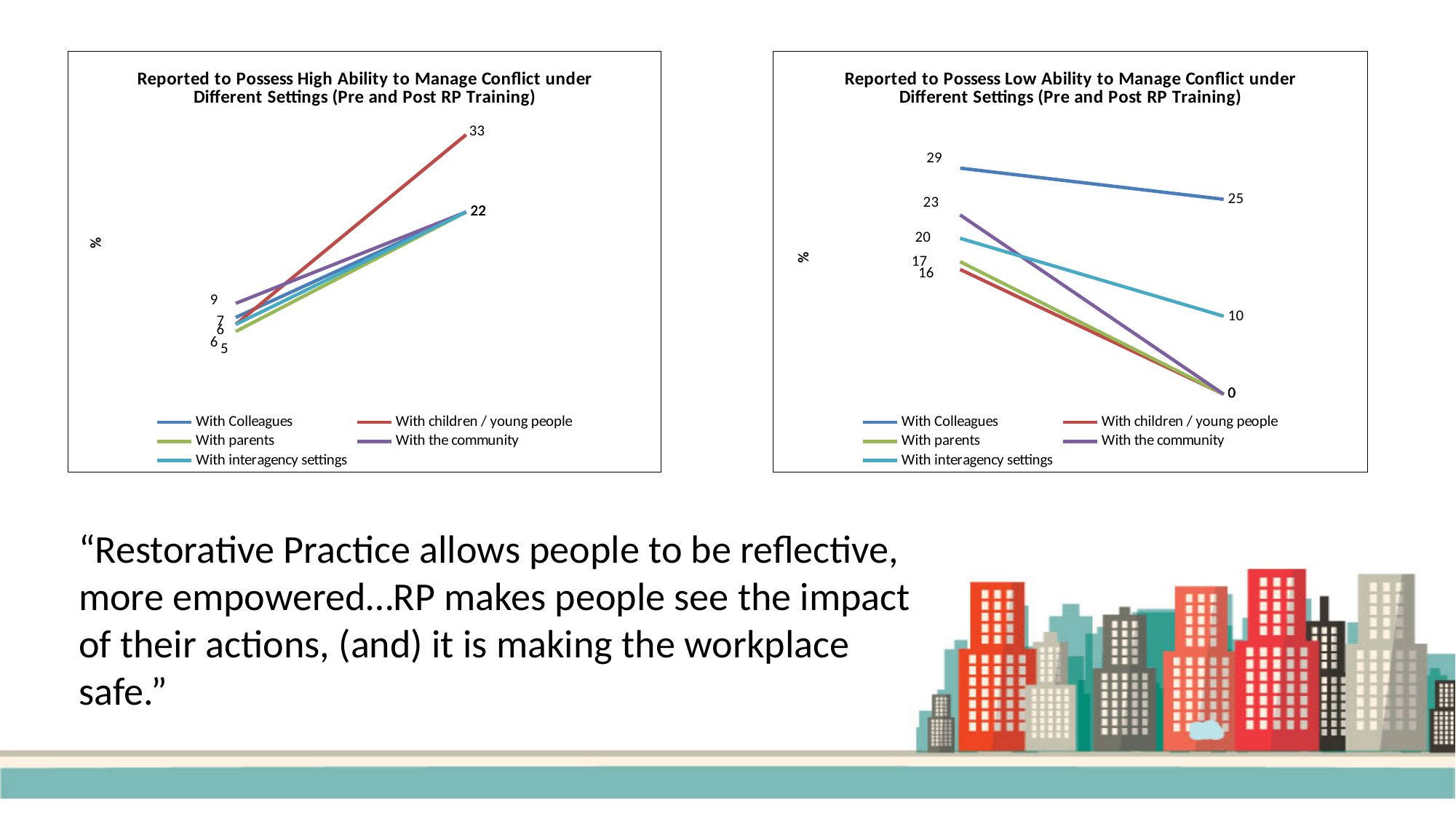
On the left chart (High Ability), what is the pre-training value for With the community? 9 On the right chart (Low Ability), what is the post-training value for With interagency settings? 10 On the left chart (High Ability), which series has the highest post-training value? With children / young people On the right chart (Low Ability), what is the pre-training value for With Colleagues? 29 On the left chart (High Ability), does the With children / young people line rise or fall from pre to post training? rises On the right chart (Low Ability), which is larger post training: With Colleagues or With interagency settings? With Colleagues On the left chart (High Ability), what is the difference between the post-training values for With children / young people and With Colleagues? 11 What kind of chart is the right chart (Low Ability)? line chart On the right chart (Low Ability), what is the difference between the pre- and post-training values for With Colleagues? 4 On the right chart (Low Ability), which series has the highest pre-training value? With Colleagues On the left chart (High Ability), what is the post-training value for With children / young people? 33 How many series does the legend of the left chart (High Ability) list? 5